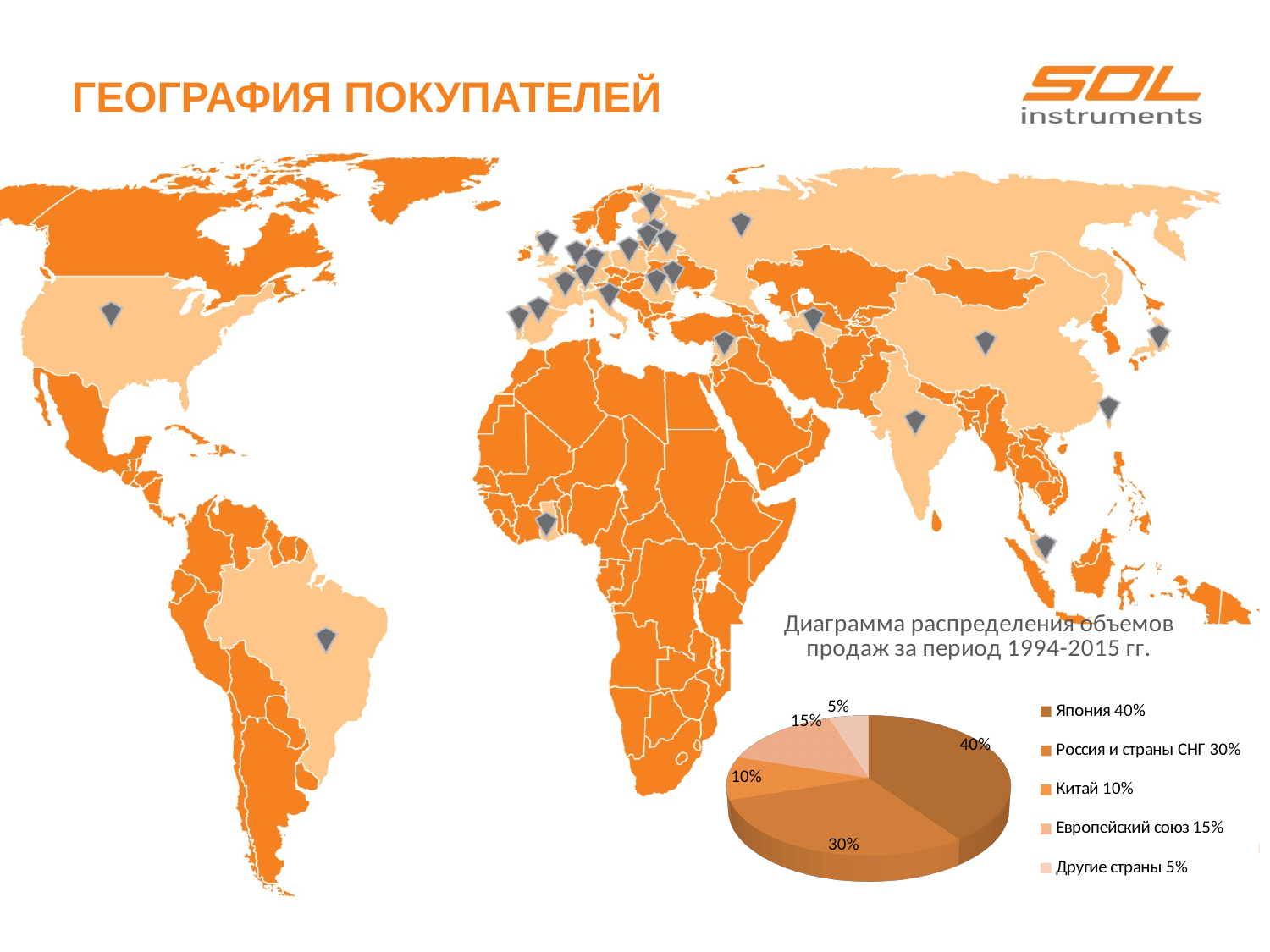
Which category has the largest share in the pie chart? Япония What share of sales does Китай have in the pie chart? 10% Which has a larger share, Европейский союз or Китай? Европейский союз How many categories does the pie chart legend list? 5 What share of sales does Европейский союз have in the pie chart? 15% What share of sales does Япония have in the pie chart? 40% What share of sales does Россия и страны СНГ have in the pie chart? 30% What is the difference between the shares of Япония and Китай? 30% What kind of chart is shown on the slide? pie chart Which category has the smallest share in the pie chart? Другие страны What is the title of the pie chart? Диаграмма распределения объемов продаж за период 1994-2015 гг. What share of sales does Другие страны have in the pie chart? 5%